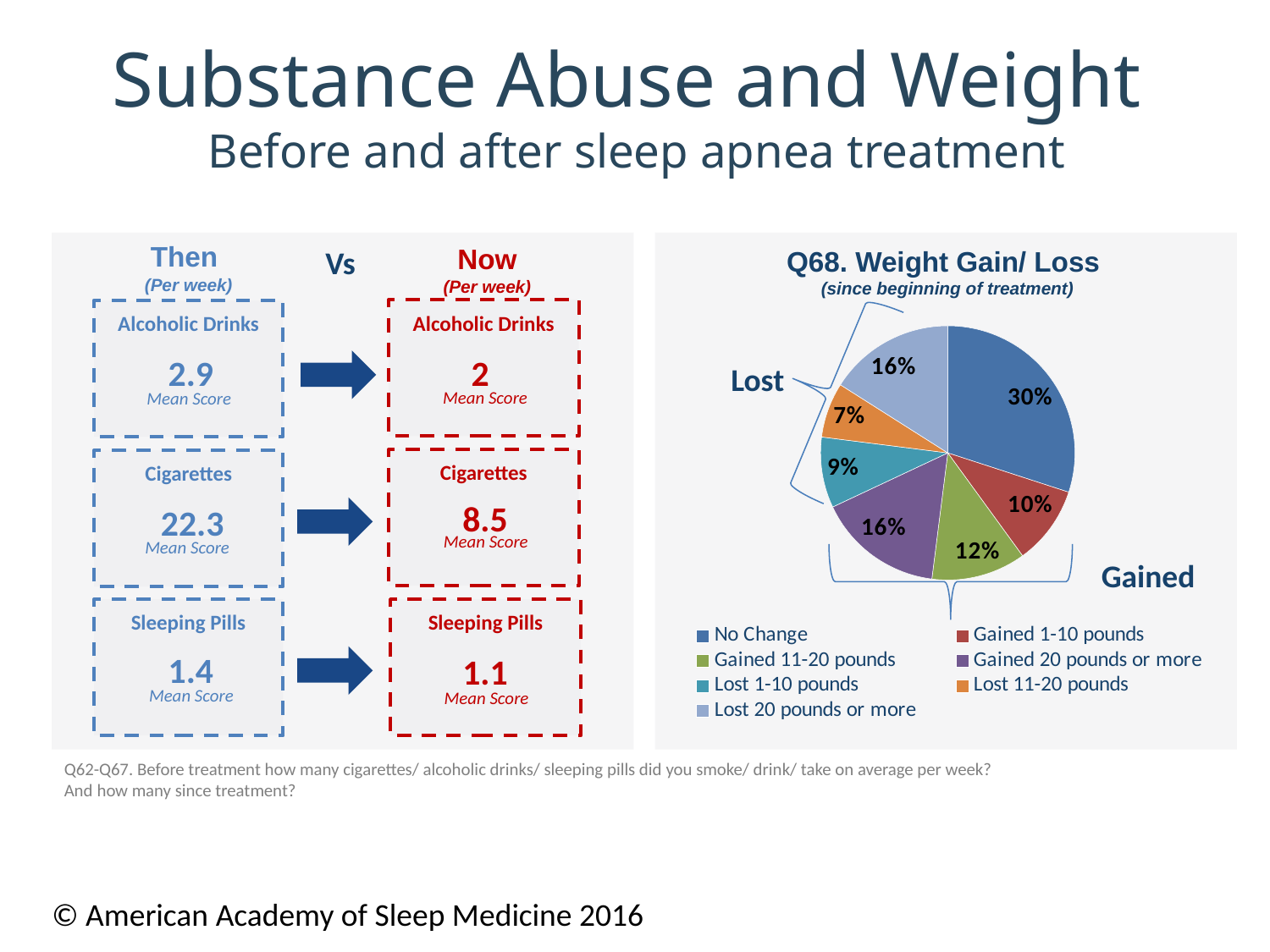
Which category has the smallest slice in the Q68. Weight Gain/ Loss pie chart? Lost 11-20 pounds In the Q68. Weight Gain/ Loss pie chart, what share of respondents reported No Change? 30% What is the subtitle shown under the title of the Q68. Weight Gain/ Loss pie chart? (since beginning of treatment) In the Q68. Weight Gain/ Loss pie chart, what percentage gained 20 pounds or more? 16% In the Q68. Weight Gain/ Loss pie chart, what percentage gained 1-10 pounds? 10% Which category has the largest slice in the Q68. Weight Gain/ Loss pie chart? No Change In the Q68. Weight Gain/ Loss pie chart, what percentage lost 11-20 pounds? 7% What kind of chart is shown on the slide? pie chart In the Q68. Weight Gain/ Loss pie chart, which is larger: Gained 11-20 pounds or Lost 1-10 pounds? Gained 11-20 pounds How many categories does the legend of the Q68. Weight Gain/ Loss pie chart list? 7 In the Q68. Weight Gain/ Loss pie chart, what is the difference between the No Change share and the Gained 11-20 pounds share? 18% In the Q68. Weight Gain/ Loss pie chart, what is the combined share of all three 'Gained' categories? 38%